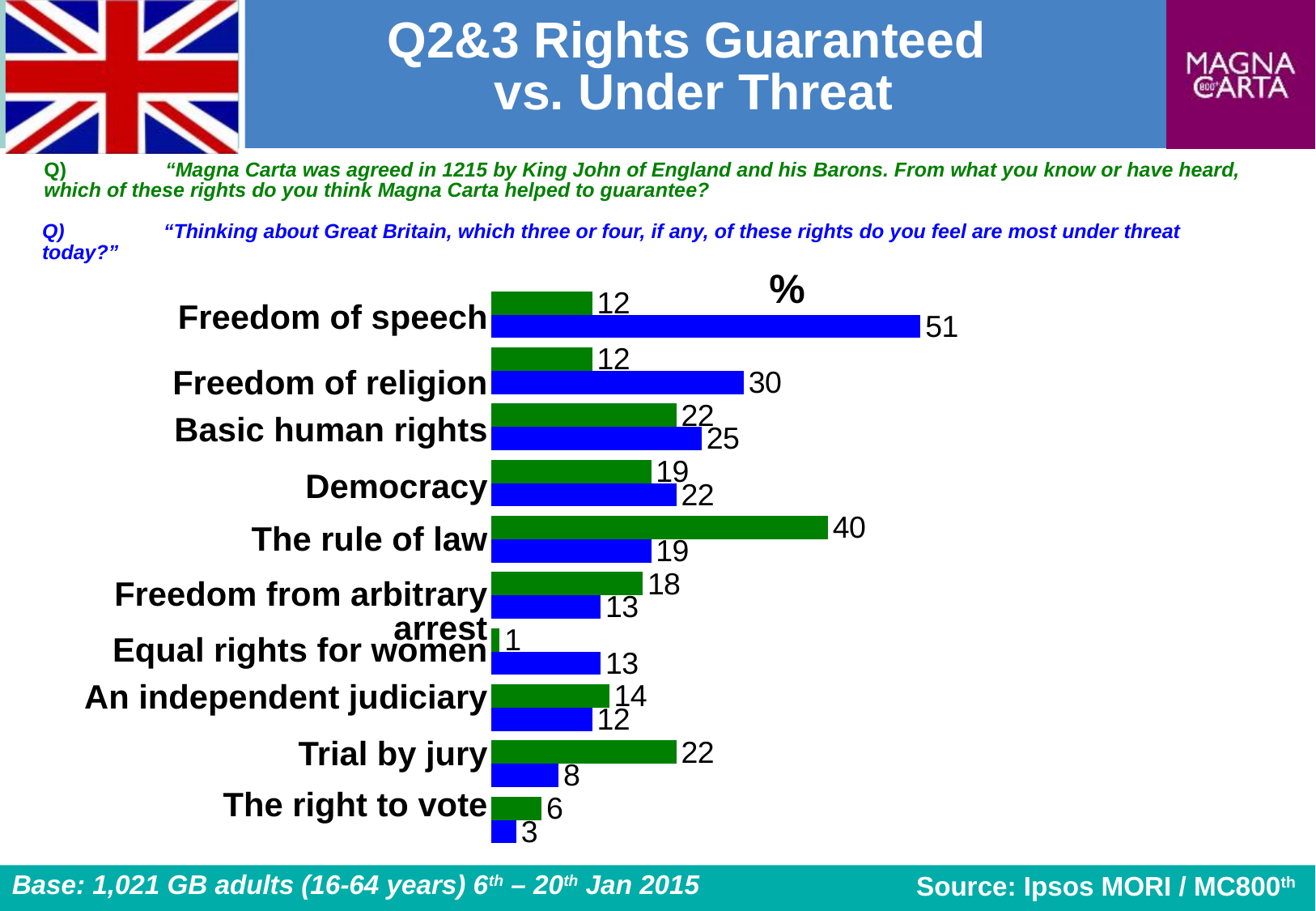
How many categories are shown on the chart? 10 Which category has the lowest green bar value? Equal rights for women What kind of chart is shown on the slide? bar chart What is the value of the blue bar for Freedom of speech? 51 What is the difference between the green and blue bar values for The rule of law? 21 Which is larger for Trial by jury, the green bar or the blue bar? the green bar What is the value of the green bar for The rule of law? 40 What is the value of the green bar for Equal rights for women? 1 Which category has the highest blue bar value? Freedom of speech What is the difference between the blue and green bar values for Freedom of speech? 39 What is the value of the blue bar for Trial by jury? 8 What is the title of the slide? Q2&3 Rights Guaranteed vs. Under Threat